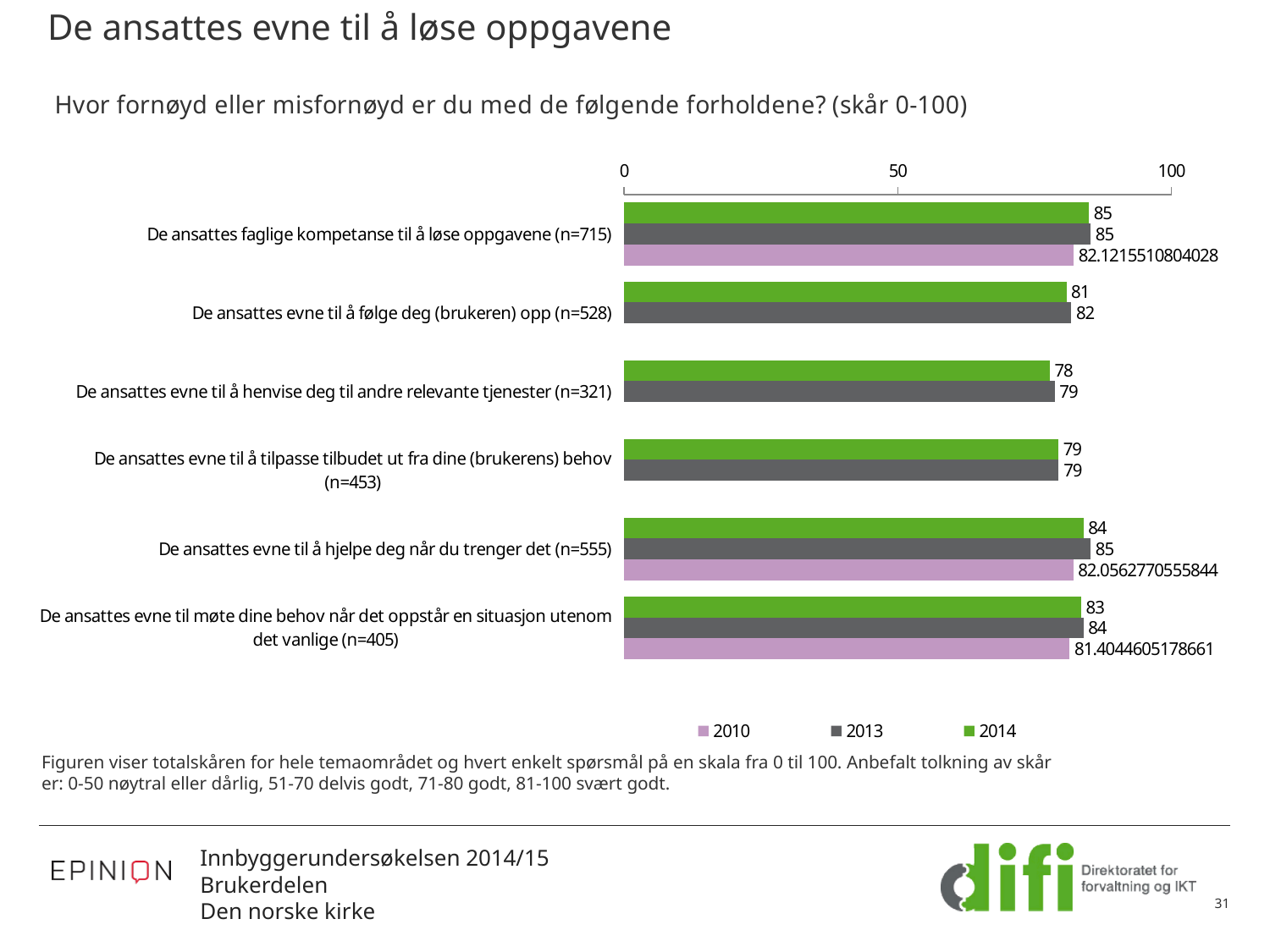
What is the 2014 value for "De ansattes faglige kompetanse til å løse oppgavene (n=715)"? 85 Which category has the lowest 2014 value? De ansattes evne til å henvise deg til andre relevante tjenester (n=321) What is the 2010 value for "De ansattes evne til å hjelpe deg når du trenger det (n=555)"? 82.0562770555844 What kind of chart is shown on the slide? bar chart What is the 2013 value for "De ansattes evne til å følge deg (brukeren) opp (n=528)"? 82 Is the 2013 value for "De ansattes evne til å tilpasse tilbudet ut fra dine (brukerens) behov (n=453)" greater or less than 50? greater How many categories are shown on the chart? 6 How many series does the legend list? 3 Which category has the highest 2014 value? De ansattes faglige kompetanse til å løse oppgavene (n=715) What is the difference between the 2014 values for "De ansattes faglige kompetanse til å løse oppgavene (n=715)" and "De ansattes evne til å henvise deg til andre relevante tjenester (n=321)"? 7 For "De ansattes evne til å møte dine behov når det oppstår en situasjon utenom det vanlige (n=405)", which is larger, the 2013 value or the 2014 value? 2013 What is the 2014 value for "De ansattes evne til å henvise deg til andre relevante tjenester (n=321)"? 78